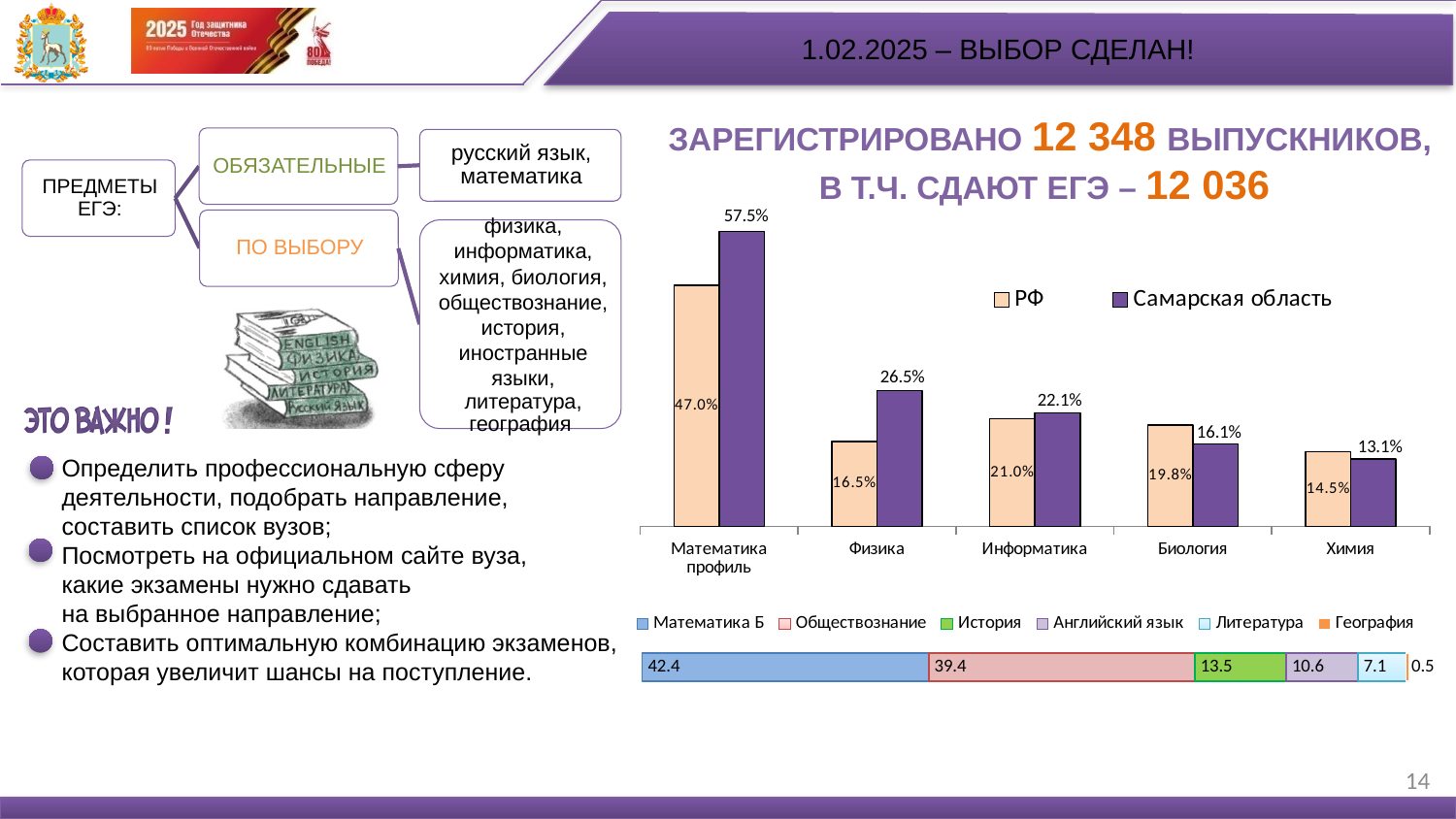
In the upper bar chart, which category has the highest value for РФ? Математика профиль In the lower stacked bar chart, which segment has the smallest value? География What kind of chart is the lower chart on the slide? Stacked bar chart In the upper bar chart, what is the value for Самарская область for Химия? 13.1% In the lower stacked bar chart, what is the value for Обществознание? 39.4 In the upper bar chart, what is the value for Самарская область for Математика профиль? 57.5% How many categories are shown on the x axis of the upper bar chart? 5 In the upper bar chart, what is the value for РФ for Физика? 16.5% In the upper bar chart, what is the difference between the Самарская область and РФ values for Информатика? 1.1% In the upper bar chart, which is larger for Биология: the РФ value or the Самарская область value? РФ How many series does the legend of the upper bar chart list? 2 In the upper bar chart, which category has the lowest value for Самарская область? Химия